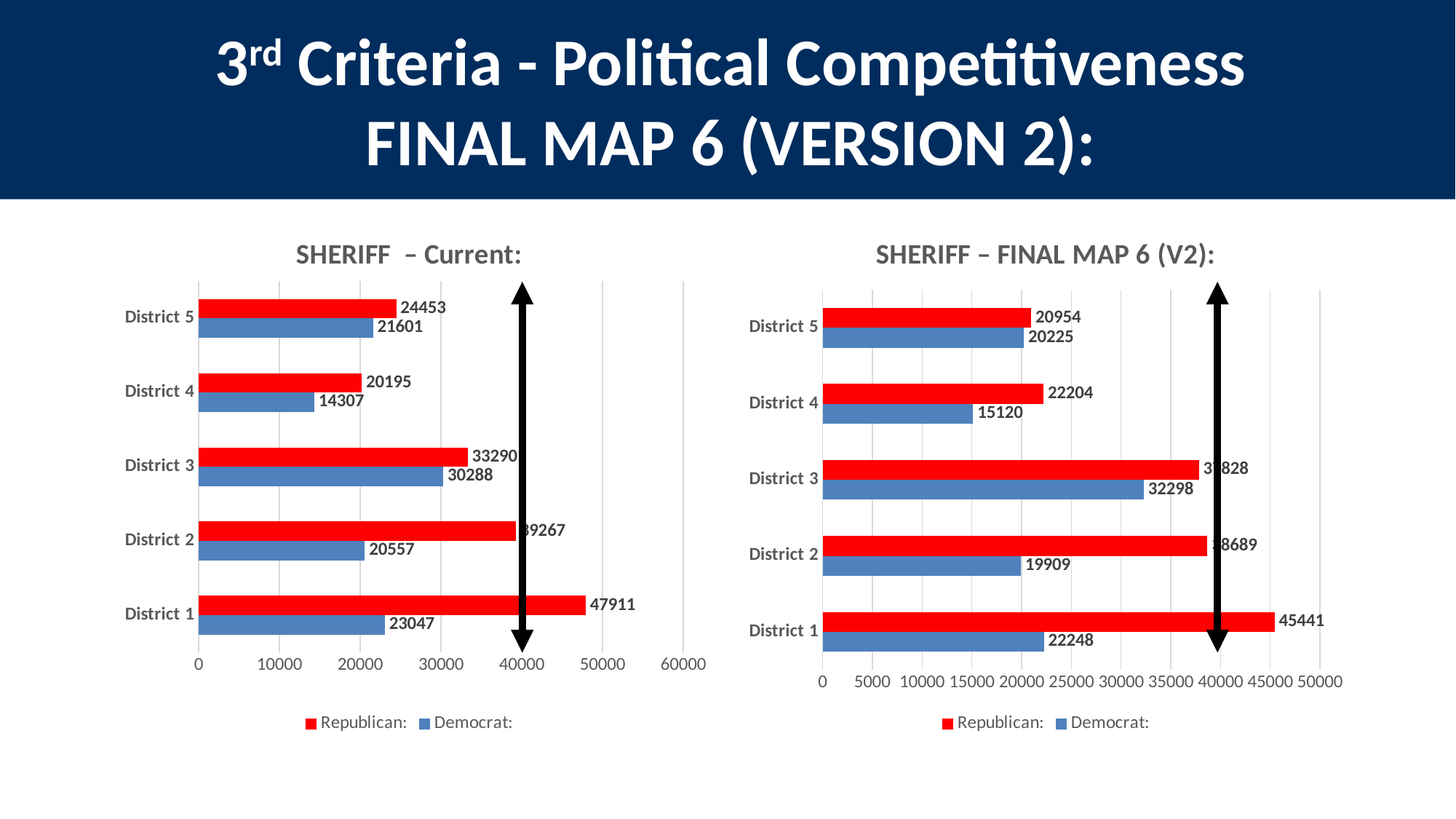
In the SHERIFF – FINAL MAP 6 (V2) chart, what is the Democrat value for District 3? 32298 In the SHERIFF – FINAL MAP 6 (V2) chart, what is the difference between the Republican and Democrat values for District 5? 729 In the SHERIFF – Current chart, which district has the highest Republican value? District 1 In the SHERIFF – Current chart, is the Democrat value for District 3 larger or smaller than the Democrat value for District 2? larger How many districts are shown in the SHERIFF – Current chart? 5 In the SHERIFF – FINAL MAP 6 (V2) chart, which district has the lowest Democrat value? District 4 In the SHERIFF – Current chart, what is the Democrat value for District 4? 14307 In the SHERIFF – FINAL MAP 6 (V2) chart, is the Republican value for District 1 greater or less than 40000? greater In the SHERIFF – Current chart, what is the difference between the Republican and Democrat values for District 1? 24864 In the SHERIFF – FINAL MAP 6 (V2) chart, what is the Republican value for District 5? 20954 How many series does the legend of the SHERIFF – FINAL MAP 6 (V2) chart list? 2 In the SHERIFF – Current chart, what is the Republican value for District 1? 47911